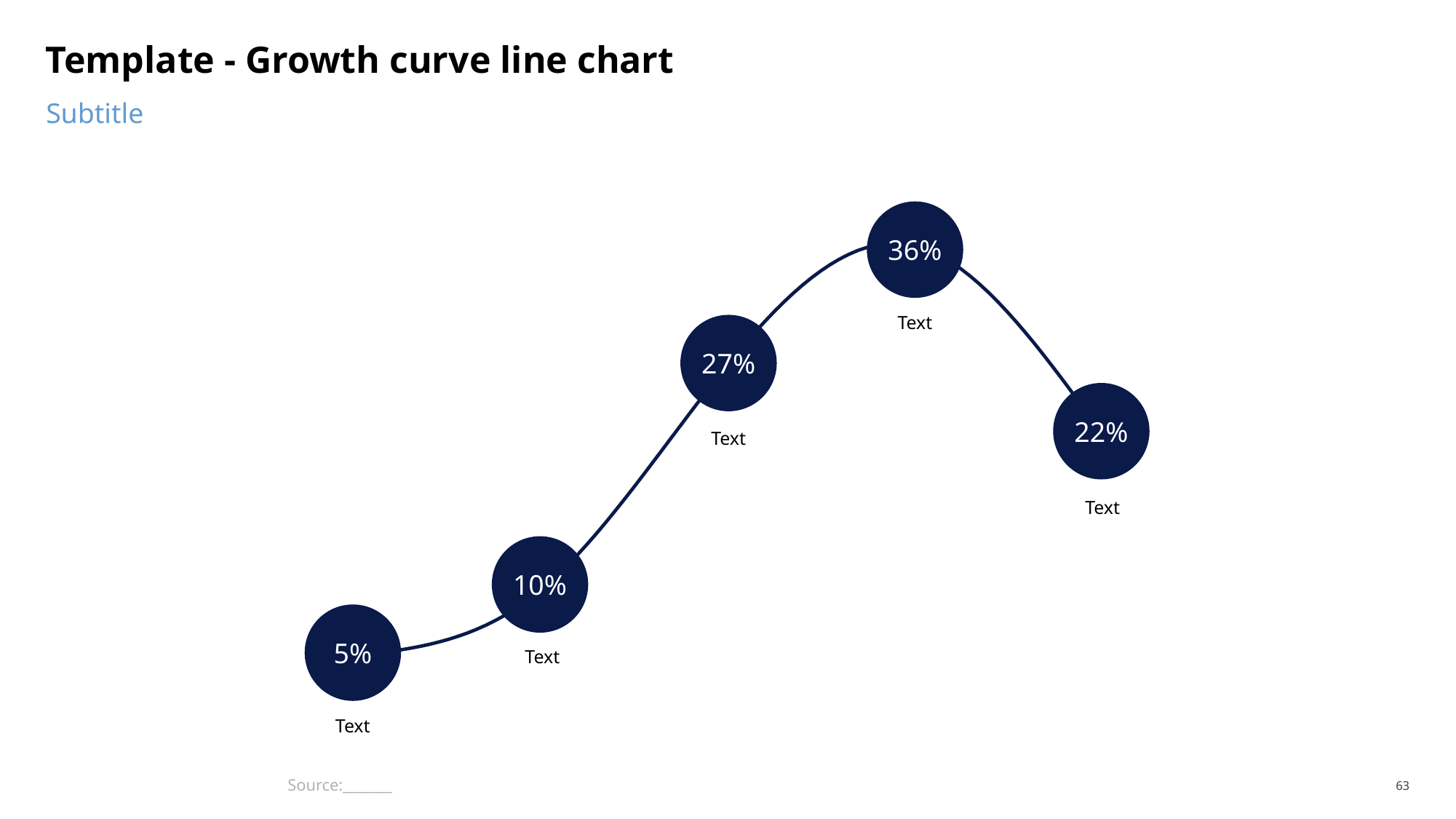
What is the title of the slide containing the line chart? Template - Growth curve line chart What is the highest value shown on the line chart? 36% What kind of chart is shown on the slide? line chart What is the value of the first (leftmost) point on the line chart? 5% What is the difference between the highest point (36%) and the rightmost point (22%)? 14% What is the value of the last (rightmost) point on the line chart? 22% What is the difference between the third point (27%) and the second point (10%)? 17% How many data points are plotted on the line chart? 5 Which is larger, the fourth point or the fifth point on the line chart? the fourth point (36%) What is the value of the second point from the left on the line chart? 10% What is the value of the third point from the left on the line chart? 27% What is the lowest value shown on the line chart? 5%